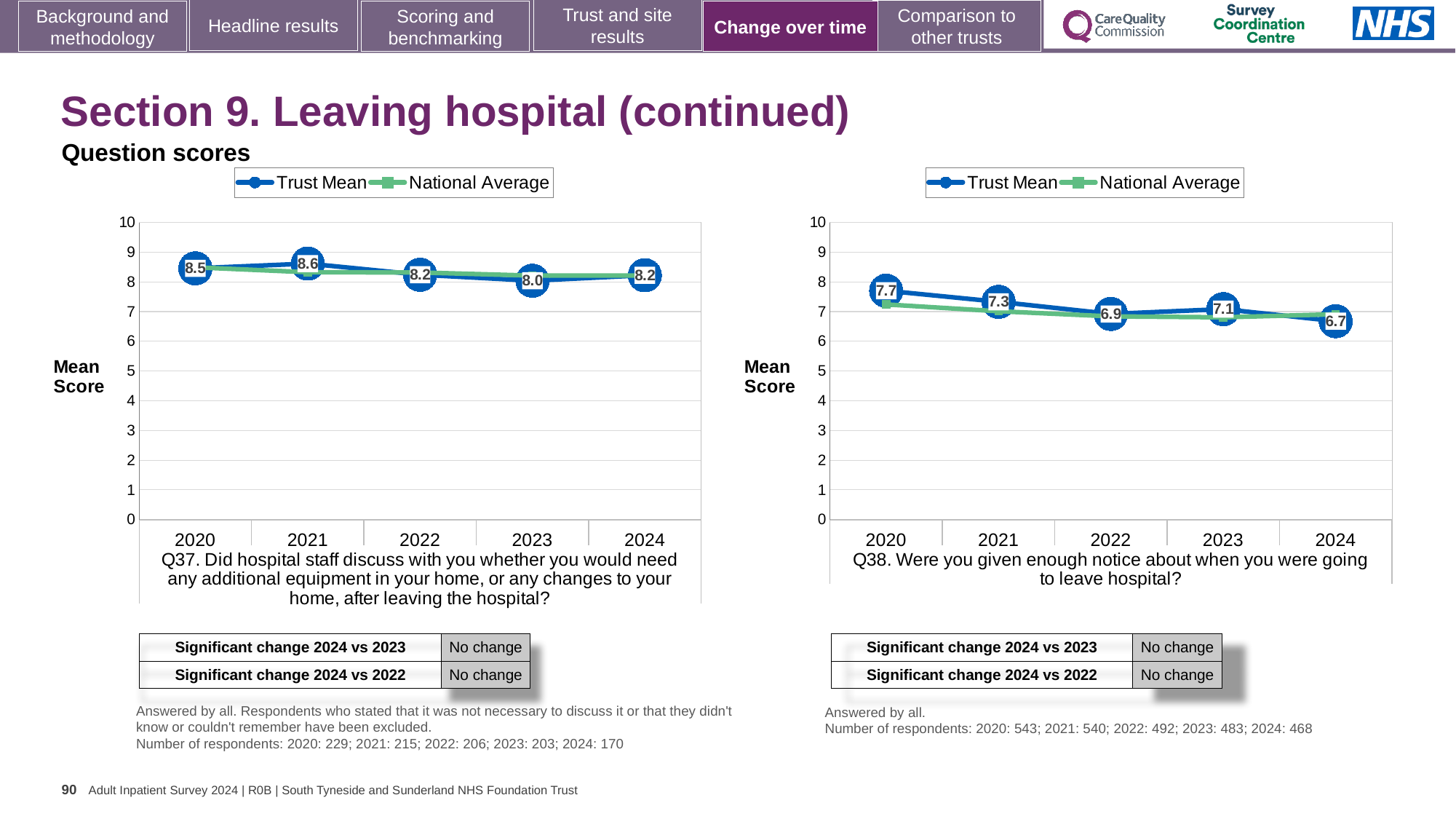
In the Q38 chart (right), what is the difference between the Trust Mean scores for 2020 and 2024? 1.0 In the Q37 chart (left), what is the Trust Mean score for 2023? 8.0 In the Q37 chart (left), is the Trust Mean score for 2020 or 2023 larger? 2020 How many years are plotted on the x axis of the Q37 chart (left)? 5 How many series does the legend of the Q38 chart (right) list? 2 In the Q37 chart (left), which year has the highest Trust Mean score? 2021 In the Q38 chart (right), is the National Average for 2020 greater or less than 8? less What type of chart is used for Q38 (right)? Line chart In the Q38 chart (right), which year has the lowest Trust Mean score? 2024 In the Q38 chart (right), what is the Trust Mean score for 2024? 6.7 In the Q38 chart (right), what is the Trust Mean score for 2020? 7.7 In the Q37 chart (left), what is the Trust Mean score for 2021? 8.6